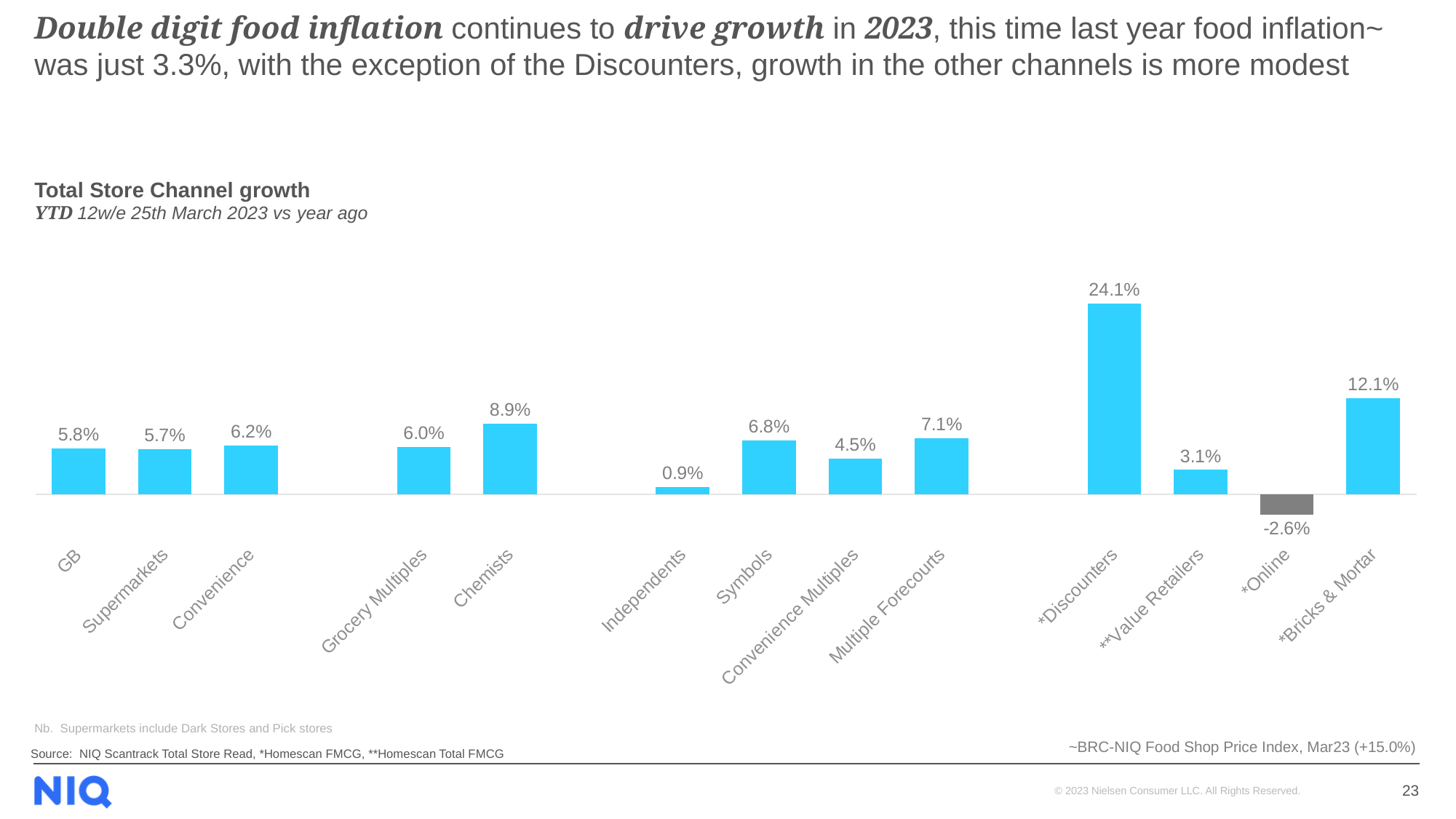
What is the growth value for *Online? -2.6% Which has higher growth, Symbols or Convenience Multiples? Symbols What kind of chart is shown on the slide? Bar chart Which bar is shown in a different colour (grey) from the others? *Online How many channels are shown in the chart? 14 Which channel has the highest growth? *Discounters What is the title of the chart? Total Store Channel growth Which channel has the lowest growth? *Online What is the growth value for GB? 5.8% What is the difference between the growth for *Discounters and *Bricks & Mortar? 12.0% What is the growth value for *Discounters? 24.1% What is the growth value for Chemists? 8.9%